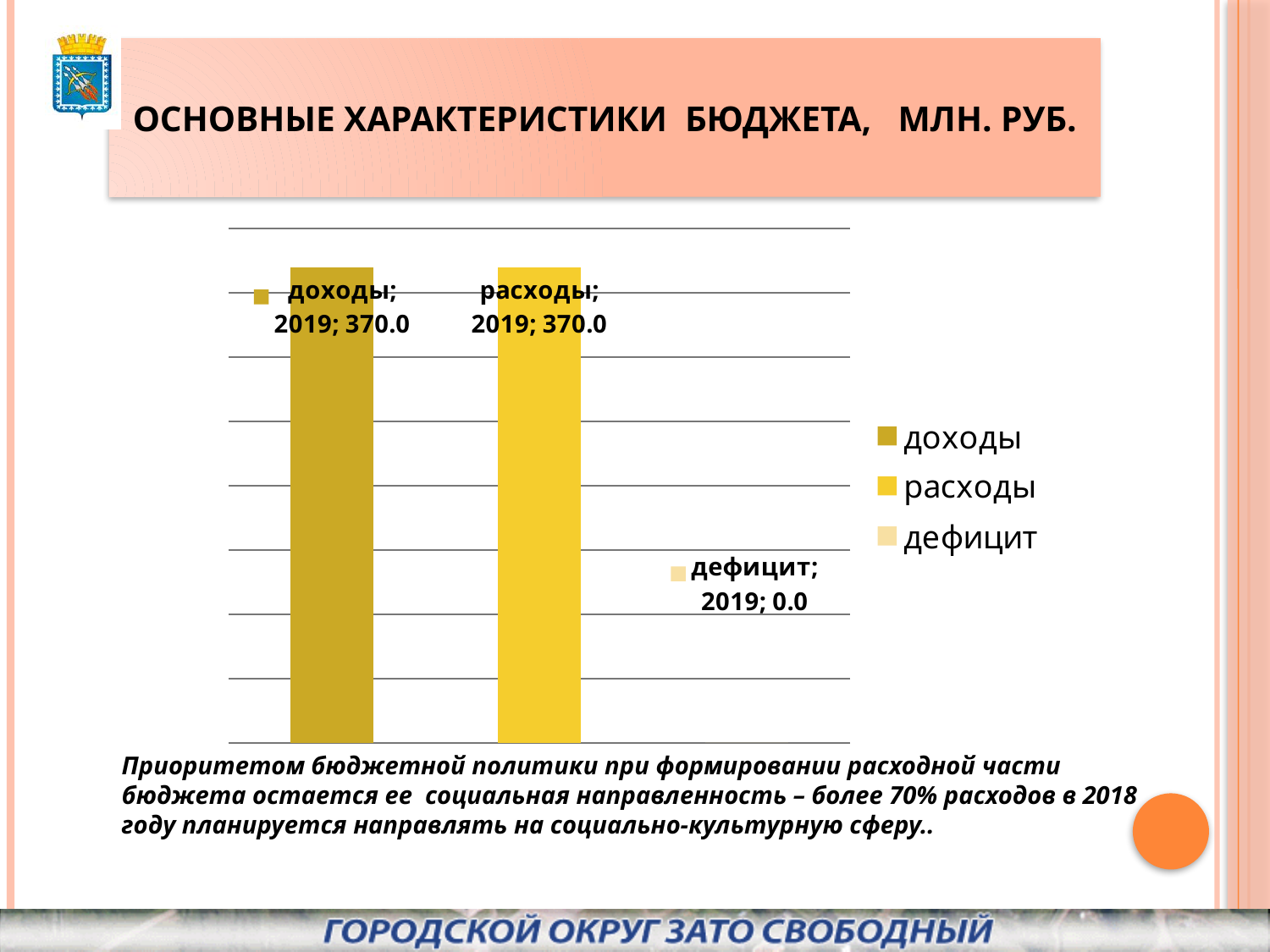
What year do the data labels on the chart refer to? 2019 What is the value for доходы in 2019? 370.0 Which is larger in 2019, расходы or дефицит? расходы What is the title of the chart on the slide? ОСНОВНЫЕ ХАРАКТЕРИСТИКИ БЮДЖЕТА, МЛН. РУБ. What is the value for дефицит in 2019? 0.0 What is the difference between доходы and расходы in 2019? 0.0 What is the value for расходы in 2019? 370.0 What kind of chart is shown on the slide? bar chart How many series does the legend list? 3 What is the difference between доходы and дефицит in 2019? 370.0 Which series has the lowest value in 2019? дефицит